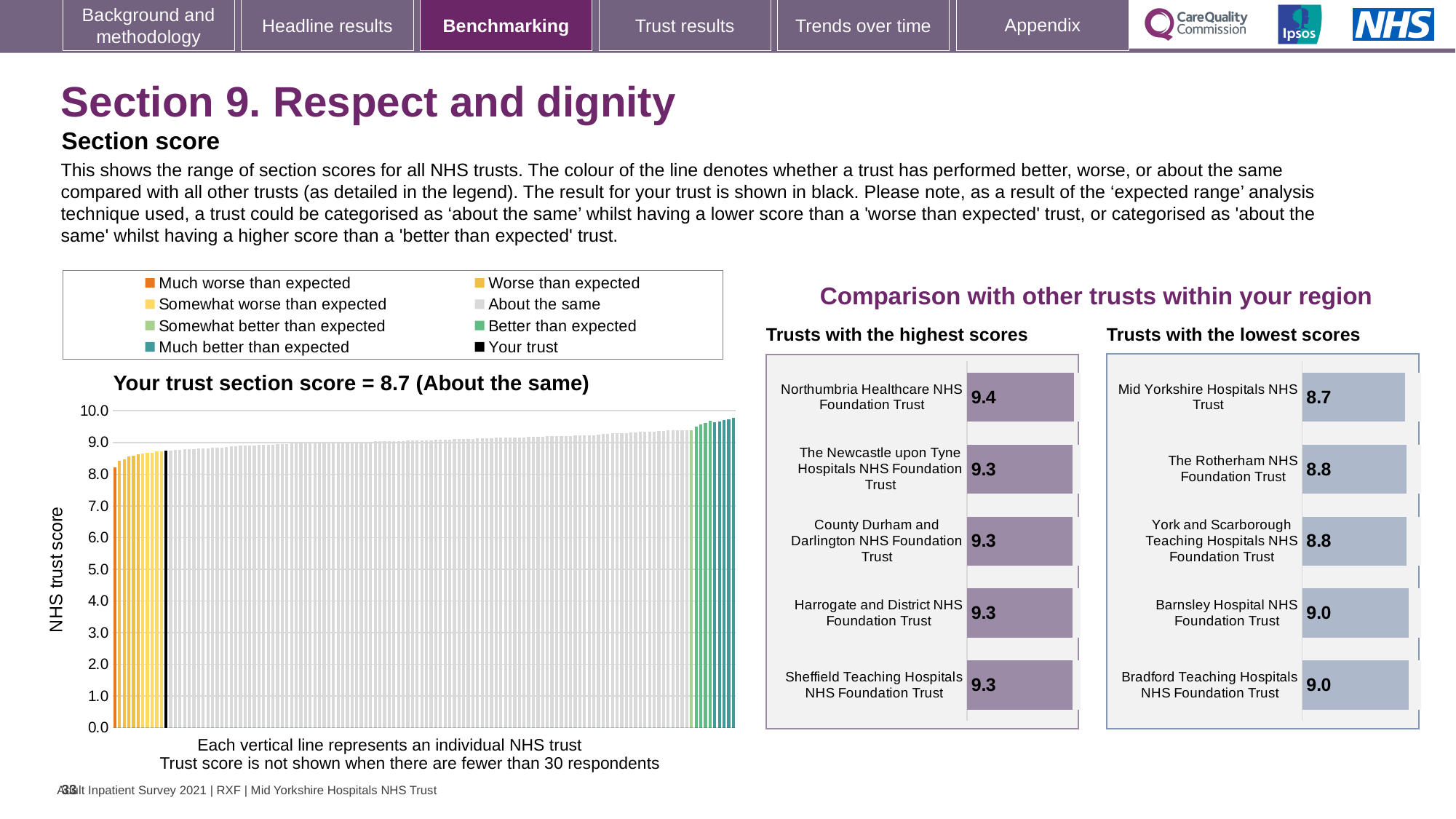
In the 'Your trust section score' chart, do the trust scores rise or fall from left to right? rise In the 'Trusts with the highest scores' chart, how many trusts are shown? 5 In the 'Trusts with the highest scores' chart, what is the difference between the scores of Northumbria Healthcare NHS Foundation Trust and Sheffield Teaching Hospitals NHS Foundation Trust? 0.1 In the 'Your trust section score' chart, what is the section score for your trust? 8.7 In the 'Trusts with the highest scores' chart, which trust has the highest score? Northumbria Healthcare NHS Foundation Trust In the 'Your trust section score' chart, which category is your trust placed in? About the same In the 'Trusts with the lowest scores' chart, what is the score for Barnsley Hospital NHS Foundation Trust? 9.0 In the 'Trusts with the highest scores' chart, what is the score for Northumbria Healthcare NHS Foundation Trust? 9.4 In the 'Trusts with the lowest scores' chart, which trust has the lowest score? Mid Yorkshire Hospitals NHS Trust How many entries does the legend above the 'Your trust section score' chart list? 8 What kind of chart is the 'Your trust section score' chart? bar chart In the 'Trusts with the lowest scores' chart, which has the larger score, The Rotherham NHS Foundation Trust or Bradford Teaching Hospitals NHS Foundation Trust? Bradford Teaching Hospitals NHS Foundation Trust